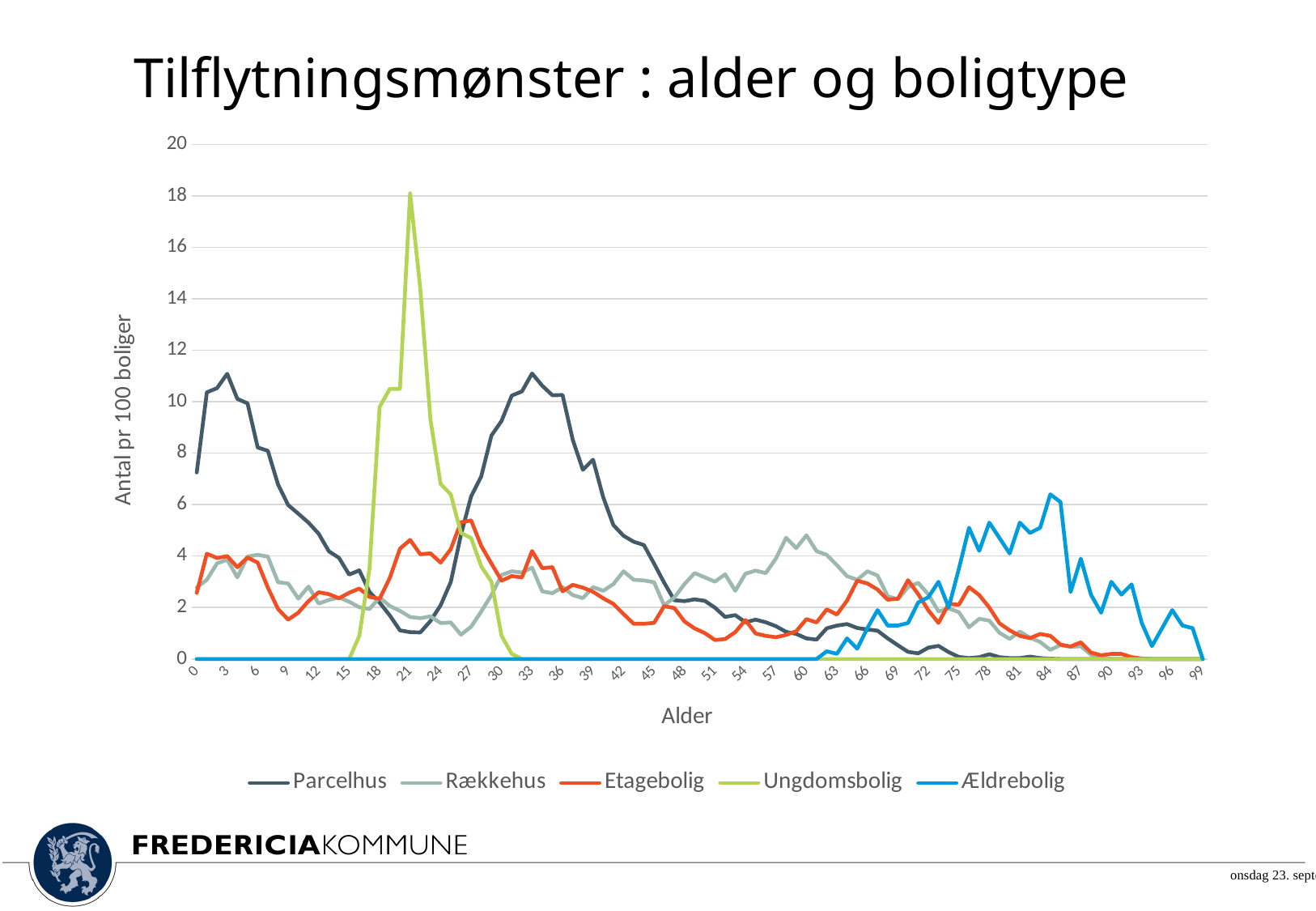
Is the value for Parcelhus at age 21 greater or less than 2? less At age 21, which series has the larger value, Ungdomsbolig or Etagebolig? Ungdomsbolig What is the label on the vertical axis? Antal pr 100 boliger How many series does the legend list? 5 Does the Parcelhus line rise or fall between age 36 and age 60? fall What kind of chart is shown on the slide? line chart Does the Ældrebolig line rise or fall between age 63 and age 84? rise What is the title of the chart? Tilflytningsmønster : alder og boligtype Is the value for Ungdomsbolig at age 21 greater or less than 16? greater Is the value for Parcelhus at age 3 greater or less than 10? greater Which series reaches the highest value anywhere on the chart? Ungdomsbolig